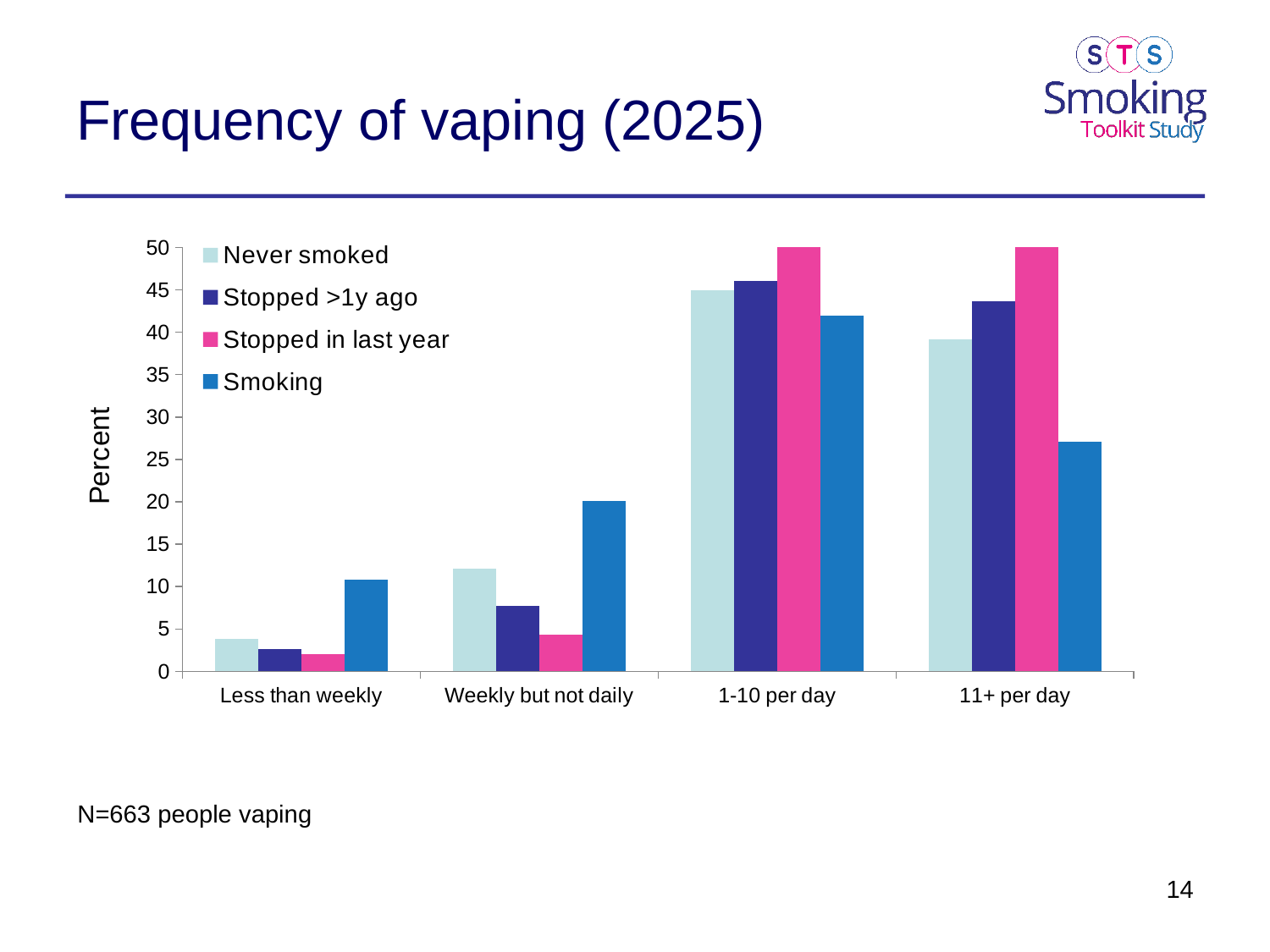
In the Weekly but not daily category, which is larger: Never smoked or Smoking? Smoking How many series does the legend list? 4 Is the value for Never smoked in the 1-10 per day category greater or less than 40? greater Which series has the highest value in the 11+ per day category? Stopped in last year How many vaping frequency categories are shown on the x axis? 4 Is the value for Stopped >1y ago in the 1-10 per day category greater or less than 40? greater Is the value for Smoking in the Less than weekly category greater or less than 15? less Which series has the lowest value in the Weekly but not daily category? Stopped in last year What kind of chart is shown on the slide? bar chart What is the label on the y axis? Percent For the Smoking series, which category has the highest value? 1-10 per day